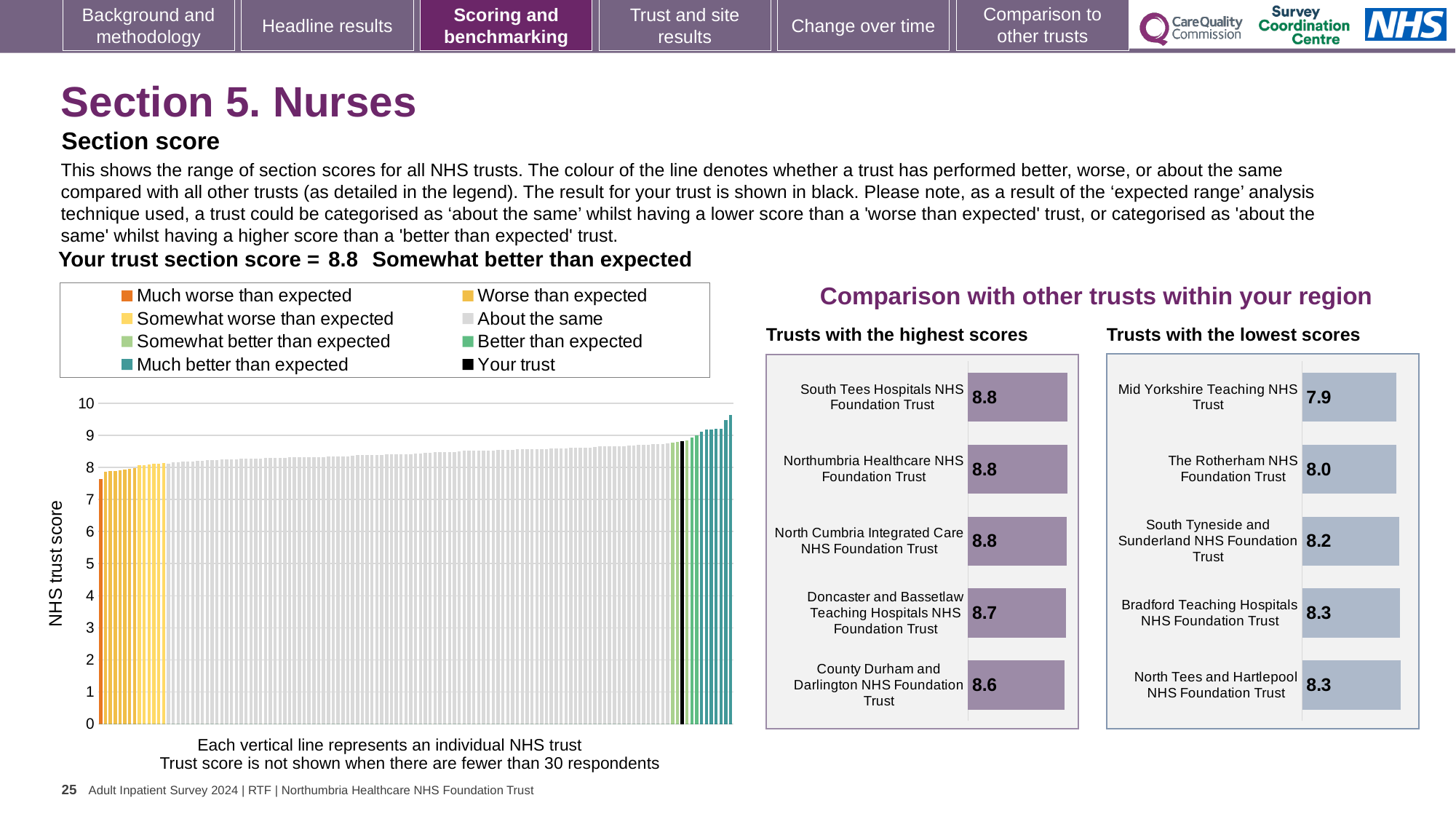
In the 'Trusts with the lowest scores' chart, which is larger: the score for The Rotherham NHS Foundation Trust or the score for Bradford Teaching Hospitals NHS Foundation Trust? Bradford Teaching Hospitals NHS Foundation Trust How many trusts are shown in the 'Trusts with the lowest scores' chart? 5 What kind of chart is the main chart on the left showing the range of section scores? bar chart In the 'Trusts with the lowest scores' chart, what is the score for South Tyneside and Sunderland NHS Foundation Trust? 8.2 In the 'Trusts with the lowest scores' chart, what is the score for Mid Yorkshire Teaching NHS Trust? 7.9 In the main chart on the left showing the range of section scores, is the value of the leftmost (orange) bar greater or less than 8? less In the 'Trusts with the highest scores' chart, what is the score for Doncaster and Bassetlaw Teaching Hospitals NHS Foundation Trust? 8.7 In the 'Trusts with the highest scores' chart, which trust has the lowest score shown? County Durham and Darlington NHS Foundation Trust In the 'Trusts with the lowest scores' chart, which trust has the lowest score? Mid Yorkshire Teaching NHS Trust In the 'Trusts with the highest scores' chart, what is the difference between the scores of South Tees Hospitals NHS Foundation Trust and County Durham and Darlington NHS Foundation Trust? 0.2 How many entries does the legend of the main chart on the left list? 8 In the 'Trusts with the highest scores' chart, what is the score for County Durham and Darlington NHS Foundation Trust? 8.6